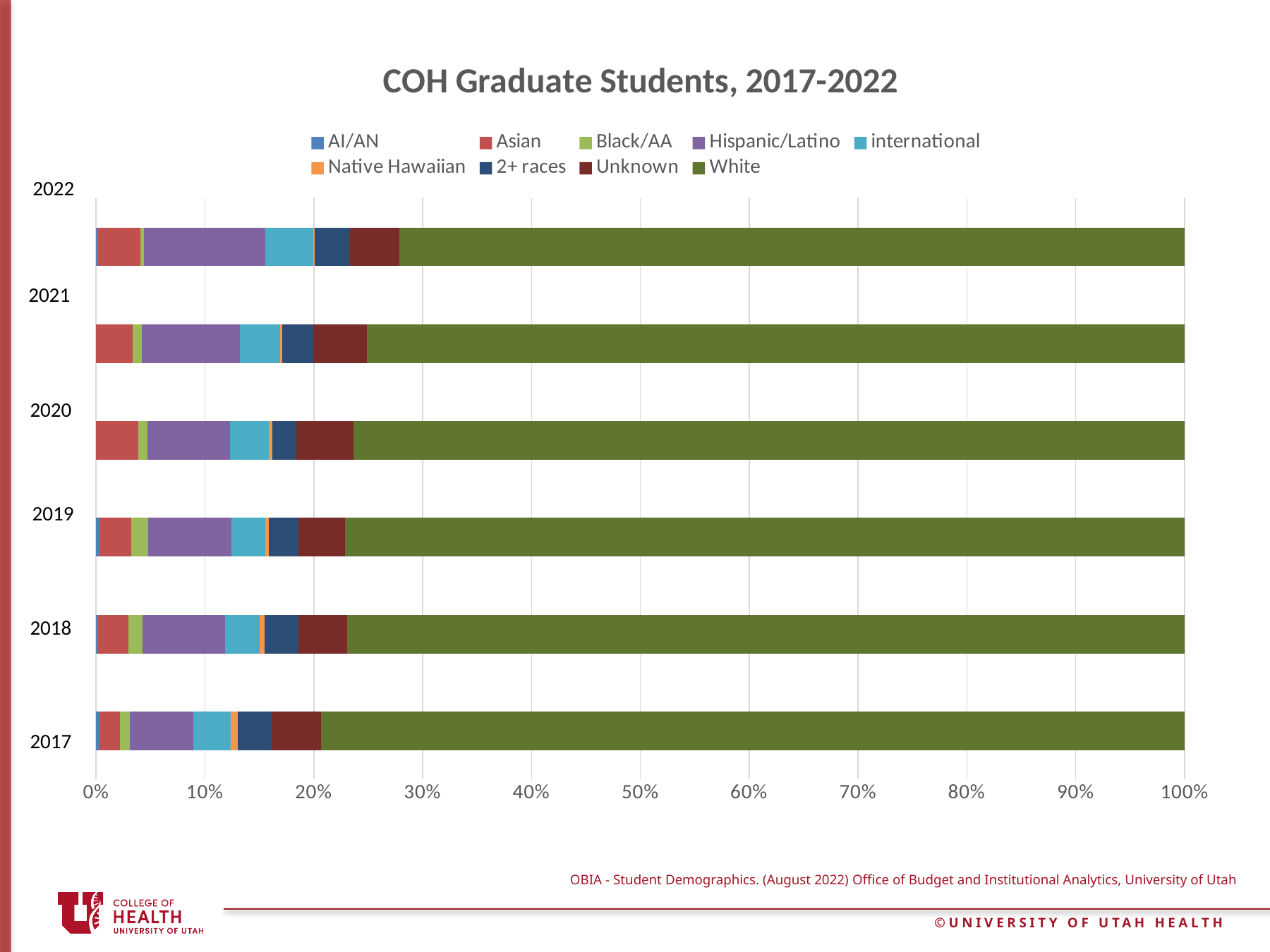
How many series does the legend list? 9 Which year has the larger Hispanic/Latino share, 2017 or 2022? 2022 Which year has the smallest White share? 2022 What kind of chart is shown on the slide? Stacked bar chart What colour represents the White series in the chart? Green Is the White share for 2017 greater or less than 70%? greater How many years (categories) are plotted on the chart? 6 Is the Hispanic/Latino share for 2022 greater or less than 20%? less Is the Asian share for 2021 greater or less than 10%? less What is the total of the stacked bar for 2019? 100% What is the title of the chart? COH Graduate Students, 2017-2022 Which year has the largest White share? 2017